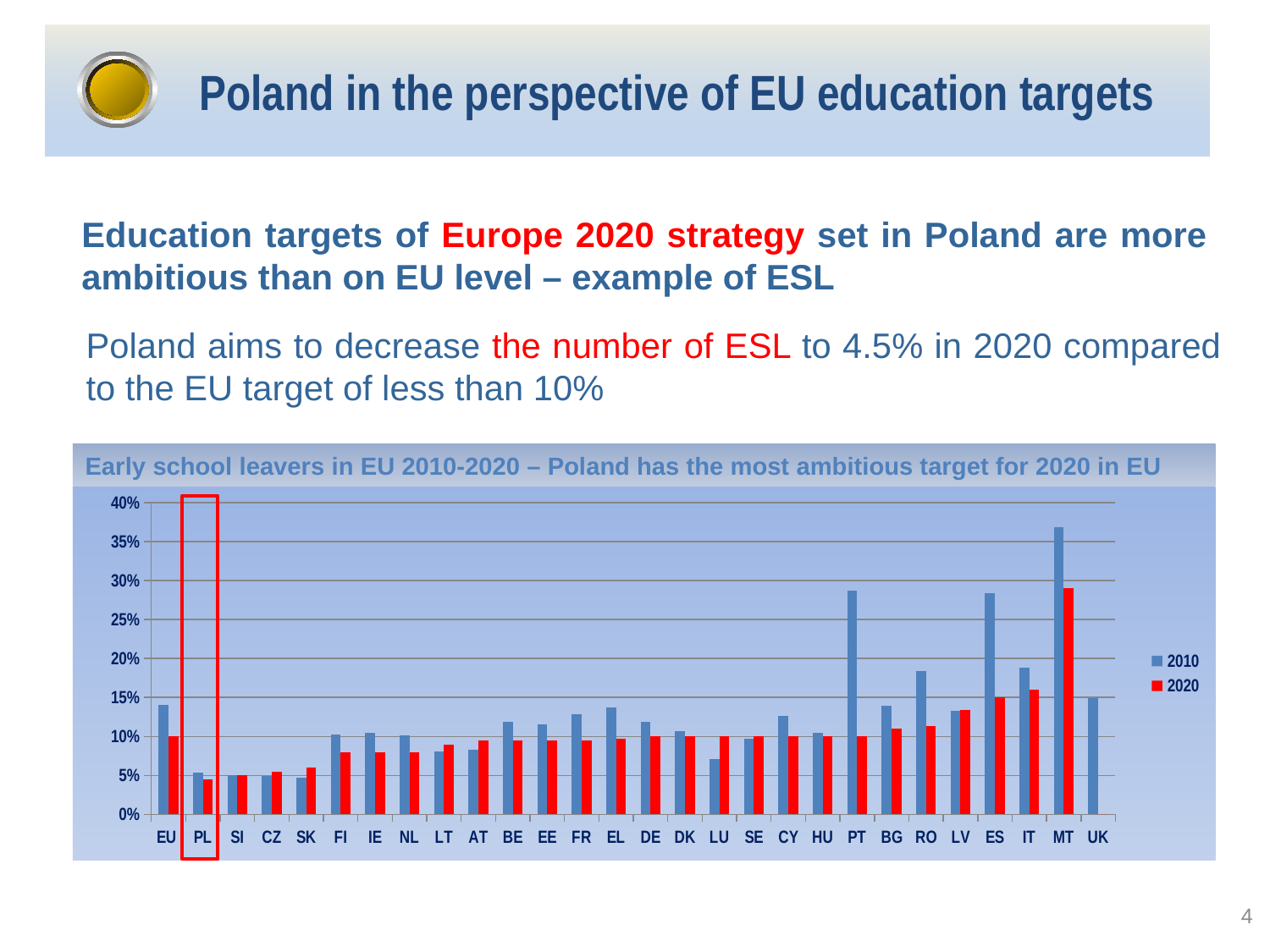
Which is larger, the 2010 value for RO or the 2010 value for BG? RO Which category has the highest value for 2010? MT How many countries/categories are shown along the x axis of the chart? 28 Is the value for PL in 2020 greater or less than 5%? less Which category has the highest value for 2020? MT Is the value for PT in 2010 greater or less than 25%? greater How many series does the chart legend list? 2 What kind of chart is shown on the slide? bar chart Is the value for MT in 2010 greater or less than 35%? greater What is the title of the chart? Early school leavers in EU 2010-2020 – Poland has the most ambitious target for 2020 in EU